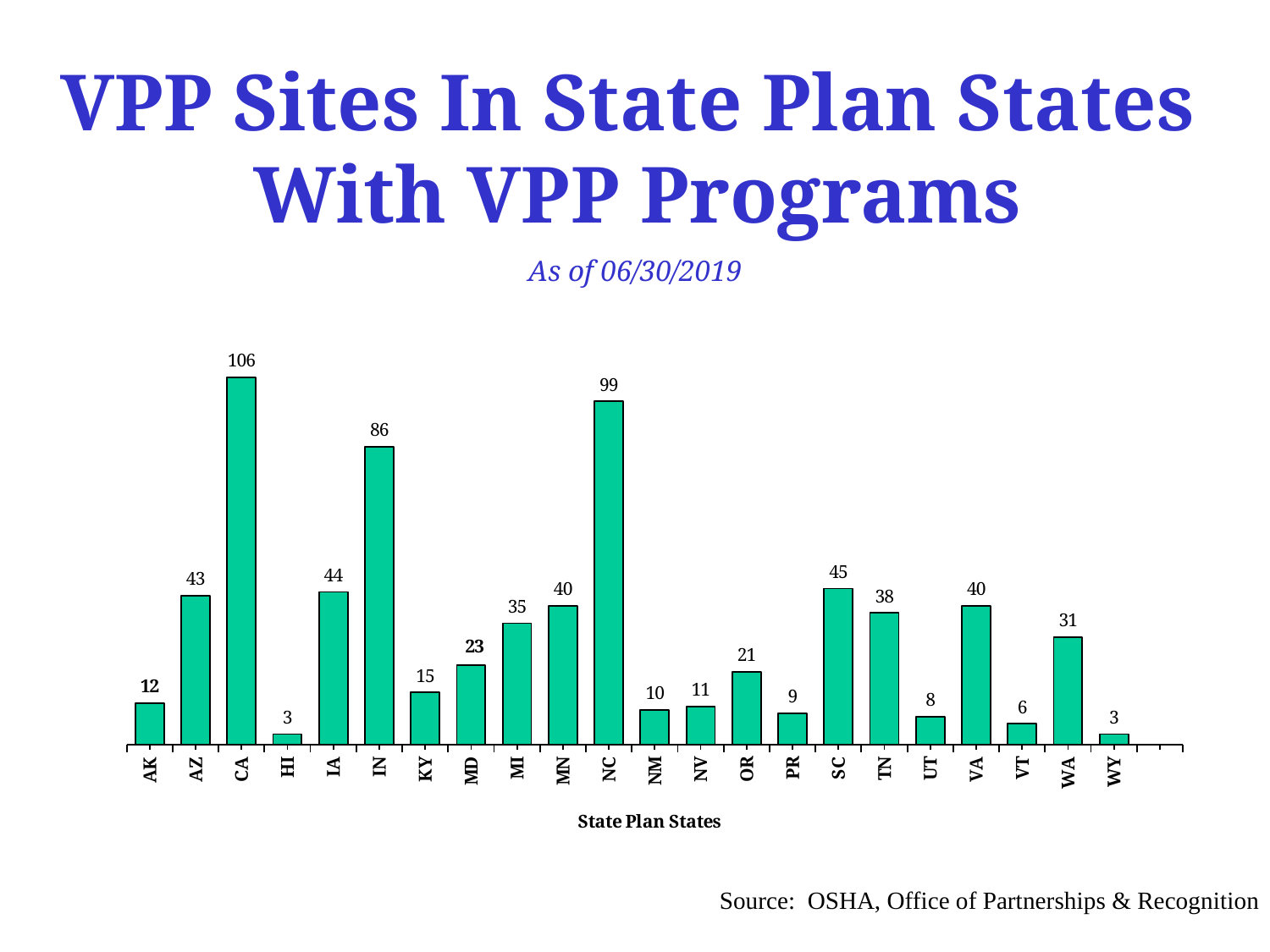
Which state has the highest number of VPP sites? CA How many states are shown on the x axis of the chart? 22 What is the number of VPP sites for CA? 106 Which has more VPP sites, SC or TN? SC What is the number of VPP sites for MD? 23 What is the number of VPP sites for NC? 99 What is the difference between the number of VPP sites in CA and NC? 7 What is the difference between the number of VPP sites in IN and IA? 42 What is the number of VPP sites for WA? 31 Which has more VPP sites, AZ or MI? AZ What is the x-axis title of the chart? State Plan States What kind of chart is shown on the slide? Bar chart